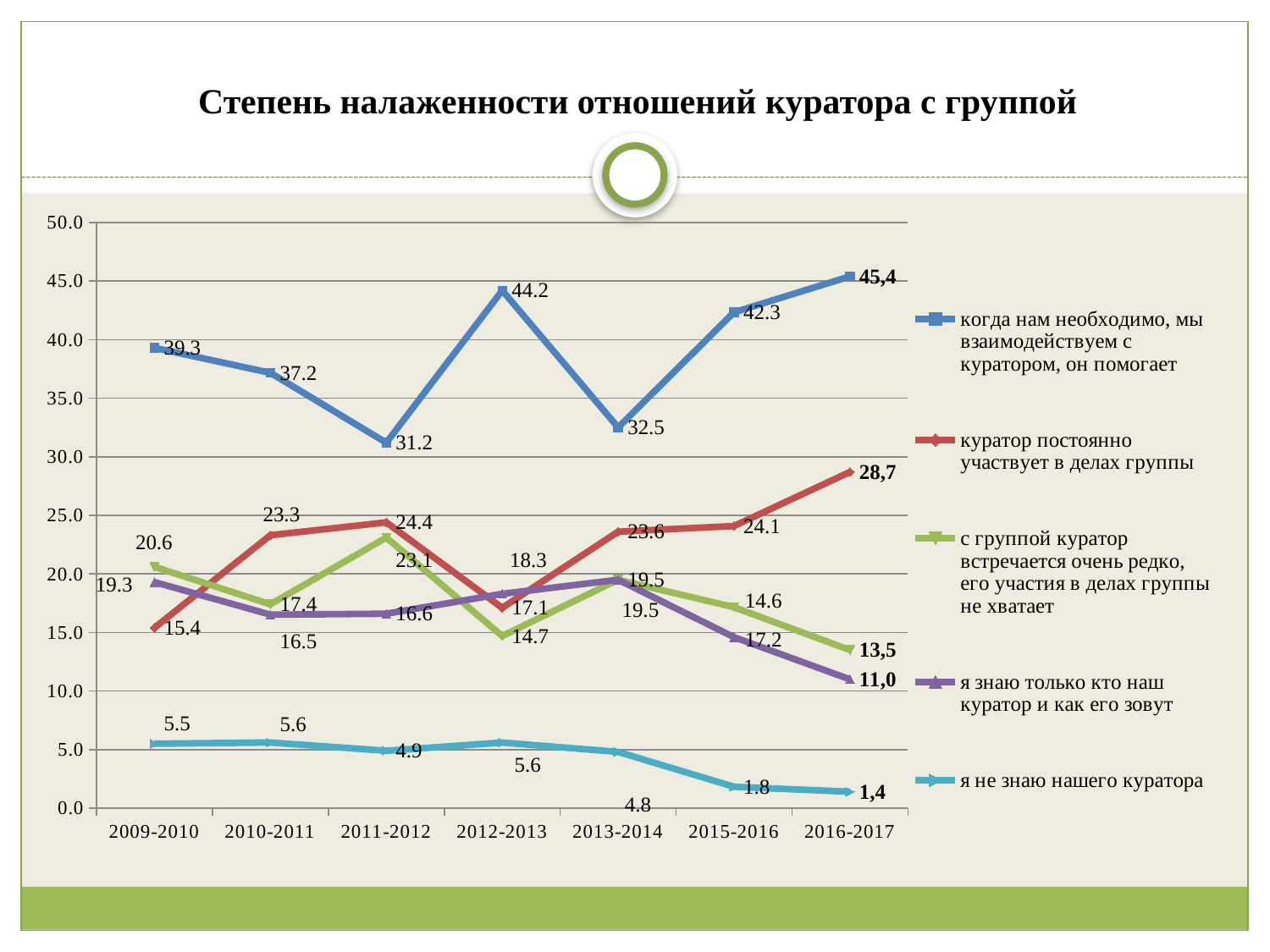
What kind of chart is shown on the slide? line chart In which year is the series "когда нам необходимо, мы взаимодействуем с куратором, он помогает" at its lowest? 2011-2012 How many series does the legend list? 5 How many academic-year categories are shown on the x axis? 7 Does the series "я не знаю нашего куратора" rise or fall overall from 2009-2010 to 2016-2017? fall What is the value for 2016-2017 in the series "куратор постоянно участвует в делах группы"? 28,7 In which year is the series "когда нам необходимо, мы взаимодействуем с куратором, он помогает" at its highest? 2016-2017 What is the difference between the 2012-2013 and 2013-2014 values of the series "когда нам необходимо, мы взаимодействуем с куратором, он помогает"? 11.7 What is the value for 2015-2016 in the series "я не знаю нашего куратора"? 1.8 What is the value for 2010-2011 in the series "куратор постоянно участвует в делах группы"? 23.3 In 2009-2010, which series has the larger value: "с группой куратор встречается очень редко, его участия в делах группы не хватает" or "куратор постоянно участвует в делах группы"? с группой куратор встречается очень редко, его участия в делах группы не хватает What is the value for 2012-2013 in the series "когда нам необходимо, мы взаимодействуем с куратором, он помогает"? 44.2